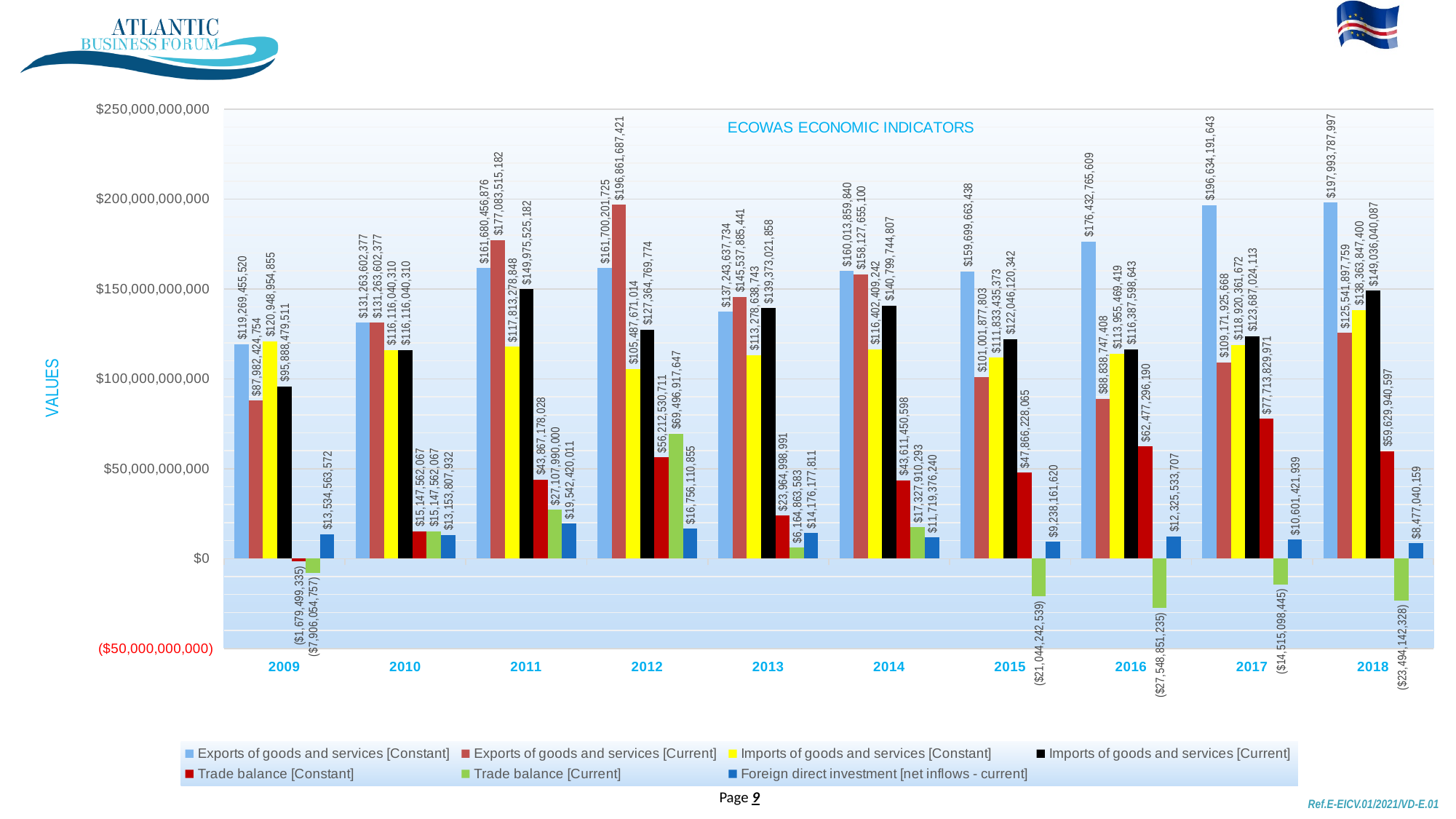
In which year is Foreign direct investment [net inflows - current] lowest? 2018 What is the value of Trade balance [Current] in 2016? ($27,548,851,235) What is the value of Exports of goods and services [Constant] in 2018? $197,993,787,997 What is the title of the chart? ECOWAS ECONOMIC INDICATORS Does Trade balance [Constant] rise or fall from 2013 to 2017? rise In which year is Exports of goods and services [Current] highest? 2012 How many series does the legend list? 7 What is the difference between Exports of goods and services [Constant] and Imports of goods and services [Constant] in 2010? $15,147,562,067 Which is larger in 2015: Exports of goods and services [Constant] or Exports of goods and services [Current]? Exports of goods and services [Constant] What is the value of Foreign direct investment [net inflows - current] in 2011? $19,542,420,011 How many years are shown on the x axis of the chart? 10 What kind of chart is shown on the slide? bar chart